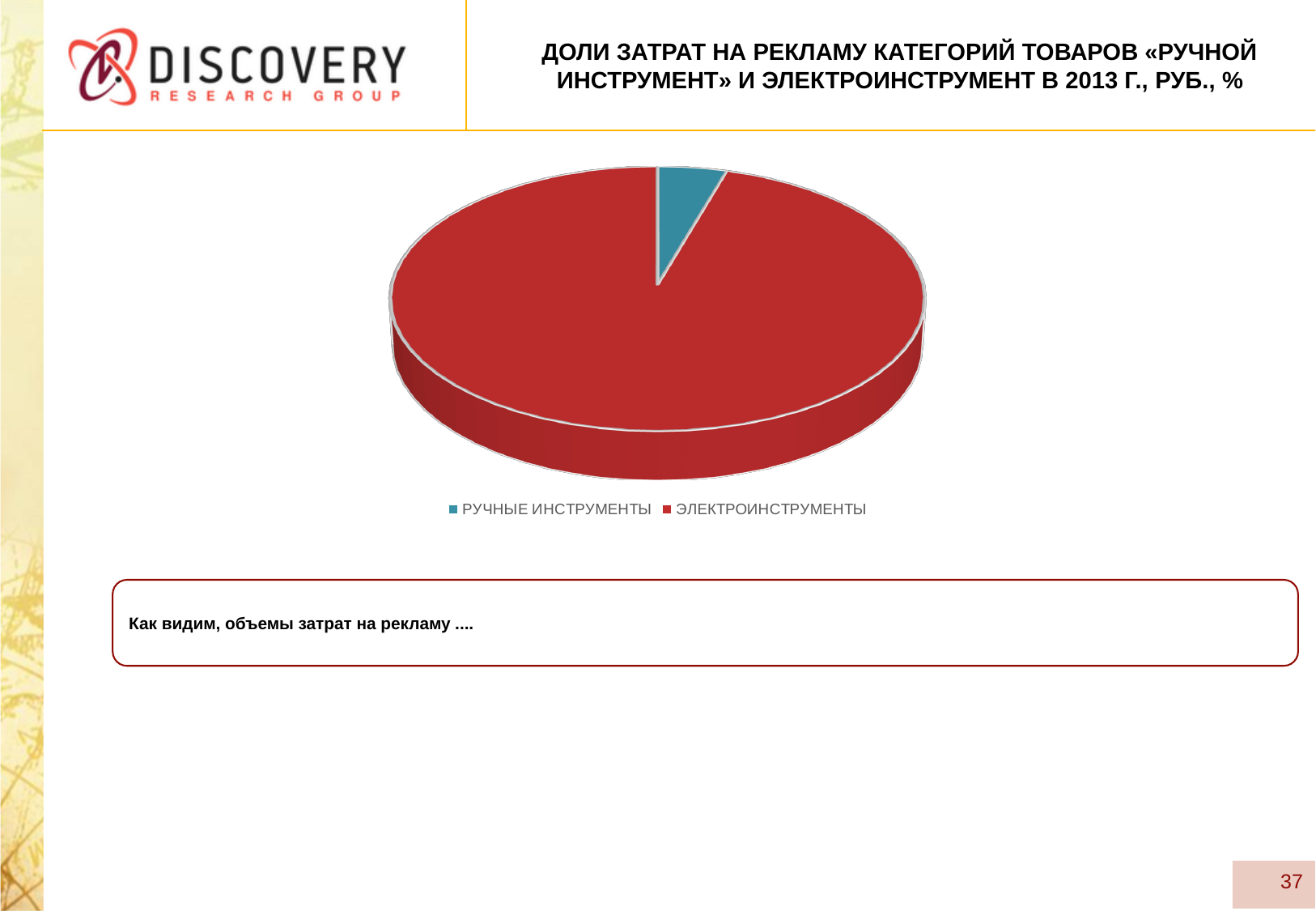
What colour is the slice for РУЧНЫЕ ИНСТРУМЕНТЫ in the pie chart? Blue Which category has the smallest share of advertising expenses in the pie chart? РУЧНЫЕ ИНСТРУМЕНТЫ What kind of chart is shown on the slide? Pie chart What year does the chart title say the advertising expense shares refer to? 2013 Which category has the largest share of advertising expenses in the pie chart? ЭЛЕКТРОИНСТРУМЕНТЫ Which slice is larger: РУЧНЫЕ ИНСТРУМЕНТЫ or ЭЛЕКТРОИНСТРУМЕНТЫ? ЭЛЕКТРОИНСТРУМЕНТЫ How many entries does the legend of the pie chart list? 2 How many slices does the pie chart have? 2